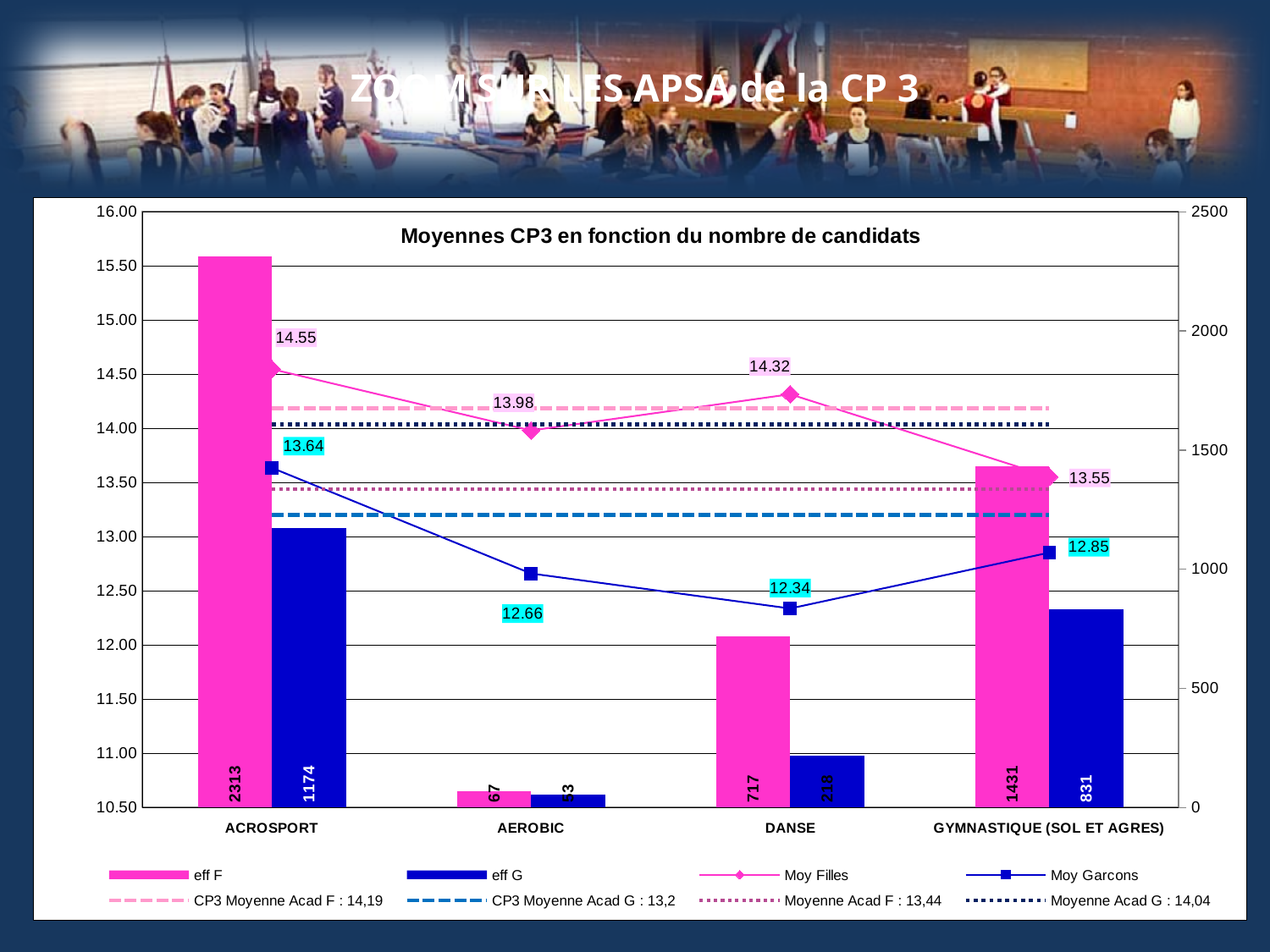
What is the eff F value for ACROSPORT? 2313 What is the difference between the eff F and eff G values for GYMNASTIQUE (SOL ET AGRES)? 600 How many categories are shown on the x axis? 4 Does the Moy Garcons line rise or fall from ACROSPORT to AEROBIC? fall How many series does the legend list? 8 Which category has the lowest Moy Garcons value? DANSE What is the title of the chart? Moyennes CP3 en fonction du nombre de candidats Which is larger, the Moy Filles value for ACROSPORT or for DANSE? ACROSPORT What is the Moy Garcons value for GYMNASTIQUE (SOL ET AGRES)? 12.85 What is the Moy Filles value for AEROBIC? 13.98 Which category has the highest eff F value? ACROSPORT What is the eff G value for DANSE? 218